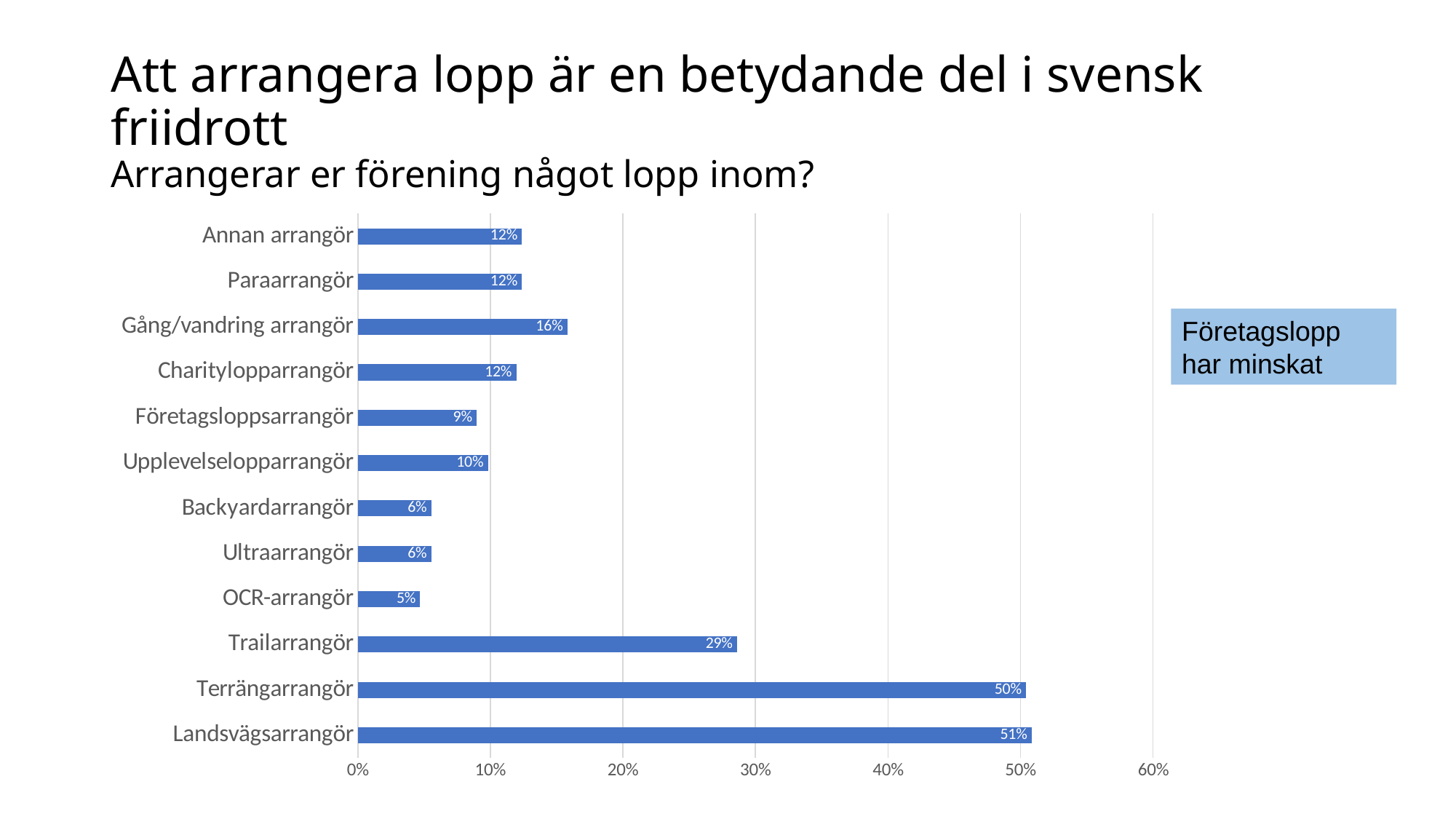
What is the value for Företagsloppsarrangör? 9% What does the text box to the right of the chart say? Företagslopp har minskat How many categories are shown in the chart? 12 What is the value for Trailarrangör? 29% Is the value for Trailarrangör greater or less than 20%? greater What is the difference between the values for Terrängarrangör and Trailarrangör? 21% What kind of chart is shown on the slide? bar chart Which is larger, the value for Upplevelseloppsarrangör or the value for Företagsloppsarrangör? Upplevelselopparrangör Which category has the highest value? Landsvägsarrangör What is the value for Gång/vandring arrangör? 16% Which category has the lowest value? OCR-arrangör What is the value for Landsvägsarrangör? 51%